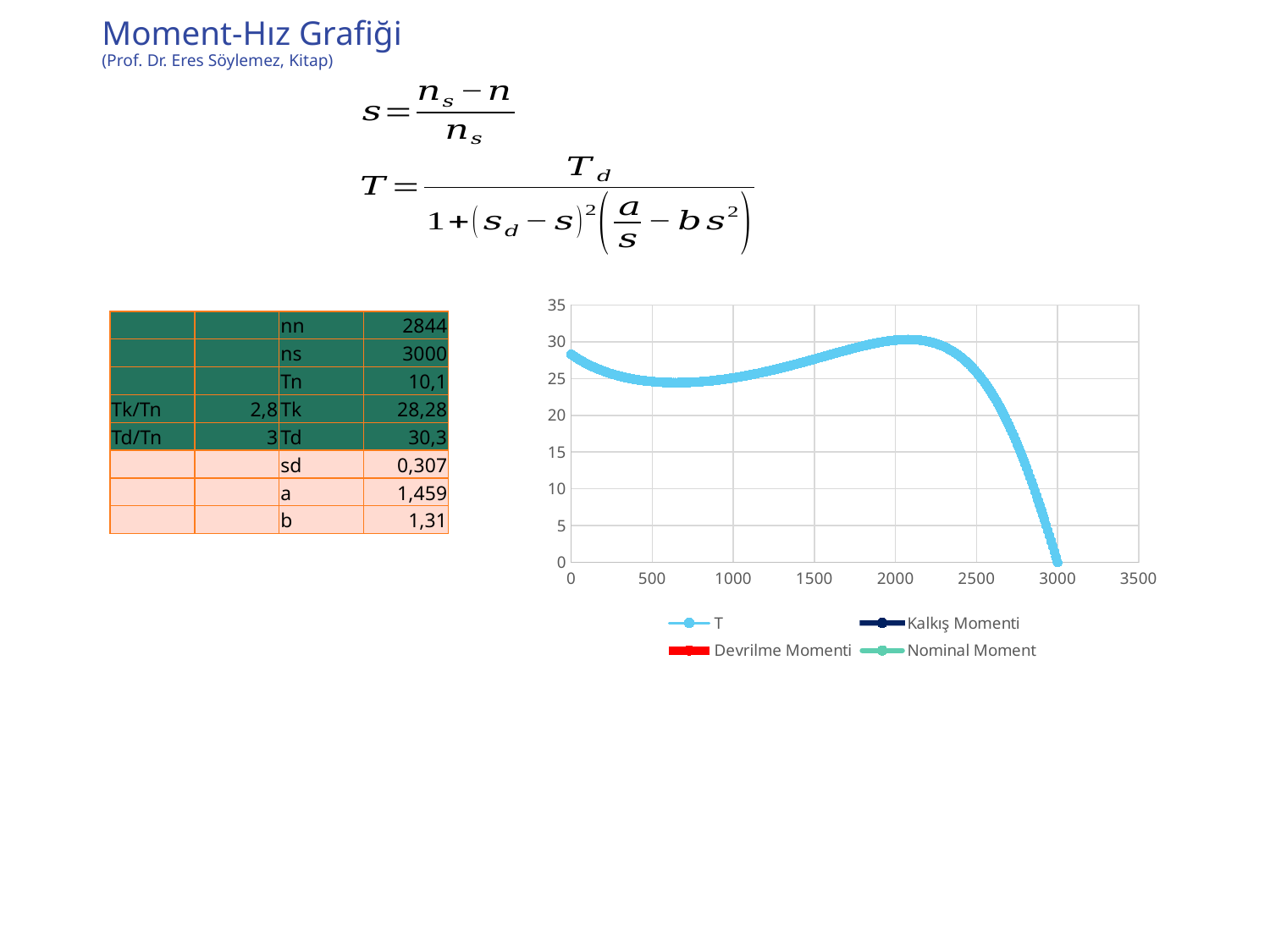
Does the T series rise or fall between x = 1000 and x = 2000? rise Is the value of the T series at x = 2000 greater or less than 25? greater Is the value of the T series at x = 500 greater or less than 30? less Is the highest point of the T curve greater or less than 25? greater What is the value of the T series at x = 3000? 0 How many series does the chart legend list? 4 Which series is plotted in light blue on the chart? T What kind of chart is shown on the slide? line chart What is the highest tick value shown on the chart's y axis? 35 Does the T series rise or fall between x = 2000 and x = 3000? fall